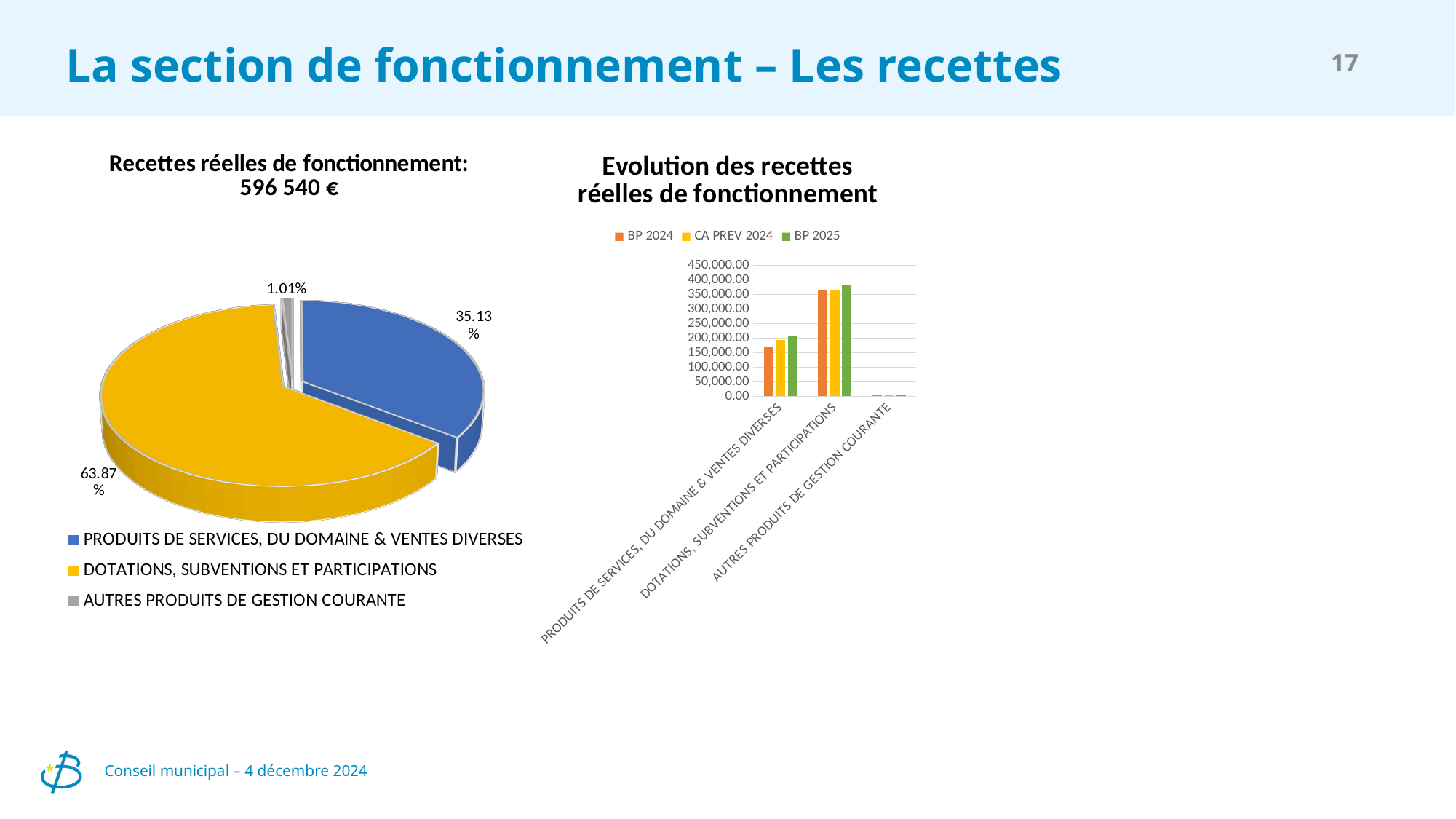
In the pie chart on the left, what share does DOTATIONS, SUBVENTIONS ET PARTICIPATIONS represent? 63.87% In the chart 'Evolution des recettes réelles de fonctionnement', is the BP 2024 value for PRODUITS DE SERVICES, DU DOMAINE & VENTES DIVERSES greater or less than 200,000.00? less How many series does the legend of the chart 'Evolution des recettes réelles de fonctionnement' list? 3 In the pie chart on the left, which category has the largest slice? DOTATIONS, SUBVENTIONS ET PARTICIPATIONS What total amount is given in the title of the pie chart on the left? 596 540 € In the pie chart on the left, what is the difference in percentage points between the DOTATIONS, SUBVENTIONS ET PARTICIPATIONS slice and the PRODUITS DE SERVICES, DU DOMAINE & VENTES DIVERSES slice? 28.74 In the pie chart on the left, what share does PRODUITS DE SERVICES, DU DOMAINE & VENTES DIVERSES represent? 35.13% In the chart 'Evolution des recettes réelles de fonctionnement', which category has the highest bars? DOTATIONS, SUBVENTIONS ET PARTICIPATIONS In the pie chart on the left, what share does AUTRES PRODUITS DE GESTION COURANTE represent? 1.01% In the pie chart on the left, which category has the smallest slice? AUTRES PRODUITS DE GESTION COURANTE In the chart 'Evolution des recettes réelles de fonctionnement', is the BP 2025 value for DOTATIONS, SUBVENTIONS ET PARTICIPATIONS greater or less than 350,000.00? greater What kind of chart is 'Evolution des recettes réelles de fonctionnement'? bar chart